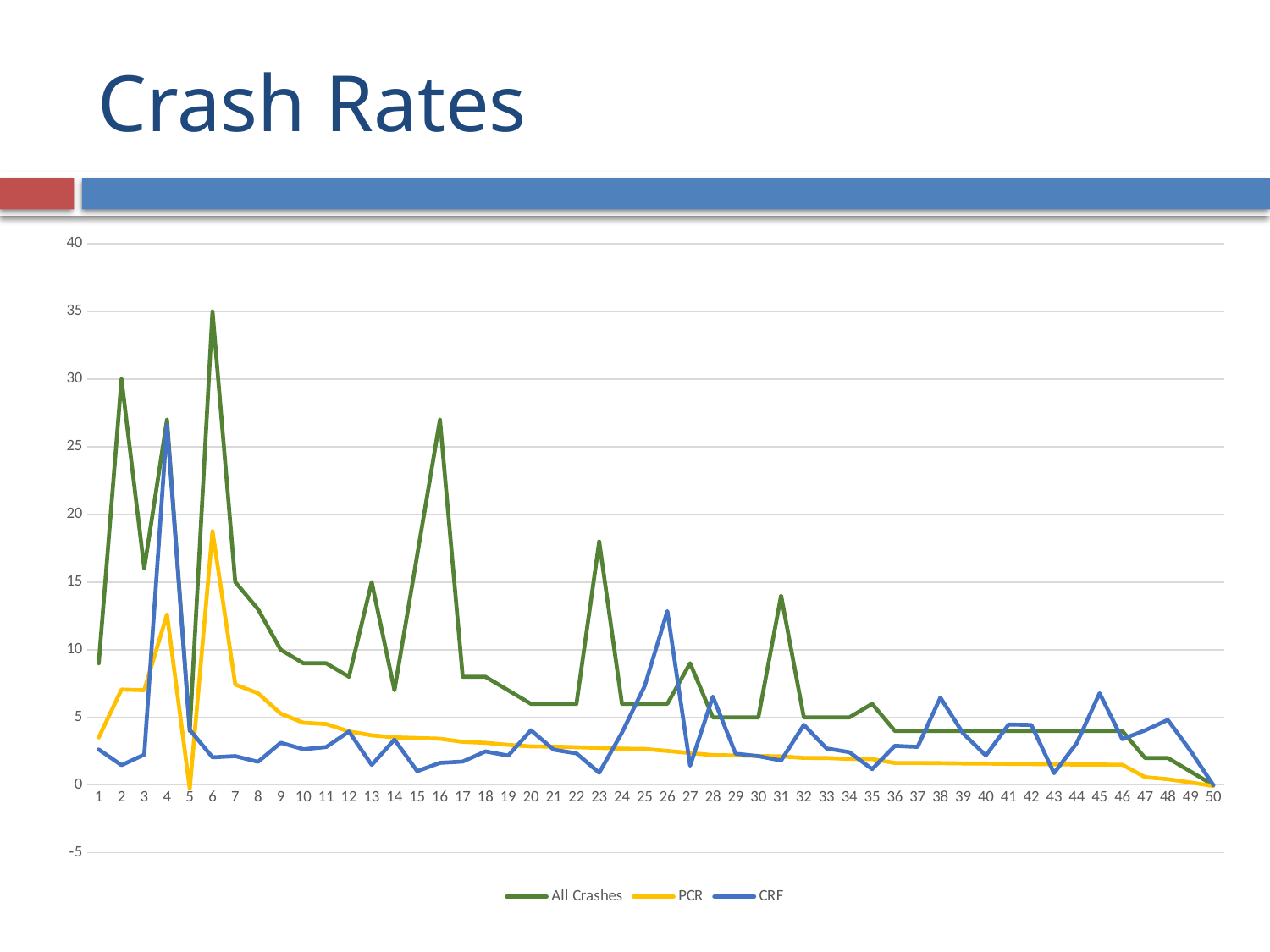
Is the value of the PCR series at point 6 greater or less than 15? greater Is the value of the PCR series at point 40 greater or less than 5? less What kind of chart is shown on the slide? line chart At which x-axis point does the All Crashes series reach its highest value? 6 What colour is the PCR line in the chart? yellow Is the value of the All Crashes series at point 16 greater or less than 25? greater Does the All Crashes series generally rise or fall from point 1 to point 50? fall What is the value of the All Crashes series at point 6? 35 At point 26, which series has the larger value, CRF or All Crashes? CRF How many series does the legend list? 3 How many points are plotted along the x axis for each series? 50